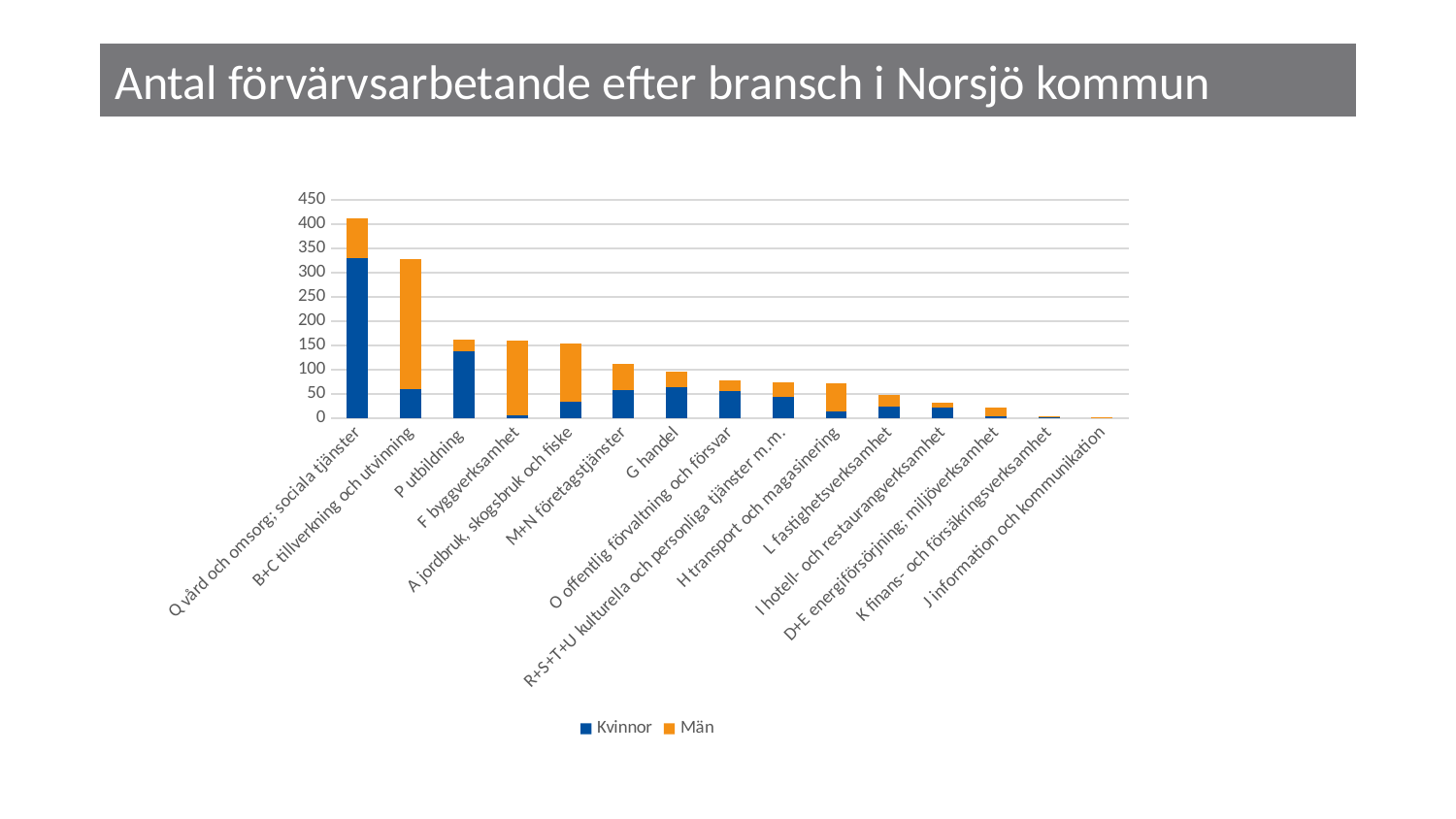
Do the total bar heights rise or fall moving from left to right along the x axis? fall Is the total value for Q vård och omsorg; sociala tjänster greater or less than 400? greater Which is larger, the Kvinnor value for Q vård och omsorg; sociala tjänster or the Kvinnor value for B+C tillverkning och utvinning? Q vård och omsorg; sociala tjänster How many series does the legend list? 2 Is the Kvinnor value for Q vård och omsorg; sociala tjänster greater or less than 300? greater Is the Kvinnor value for F byggverksamhet greater or less than 50? less How many industry categories are shown on the x axis? 15 Which category has the highest total number of employed persons? Q vård och omsorg; sociala tjänster Which is larger, the Män value for B+C tillverkning och utvinning or the Män value for Q vård och omsorg; sociala tjänster? B+C tillverkning och utvinning What kind of chart is shown on the slide? Stacked bar chart Which two series are shown in the legend? Kvinnor and Män Which category has the lowest total number of employed persons? J information och kommunikation